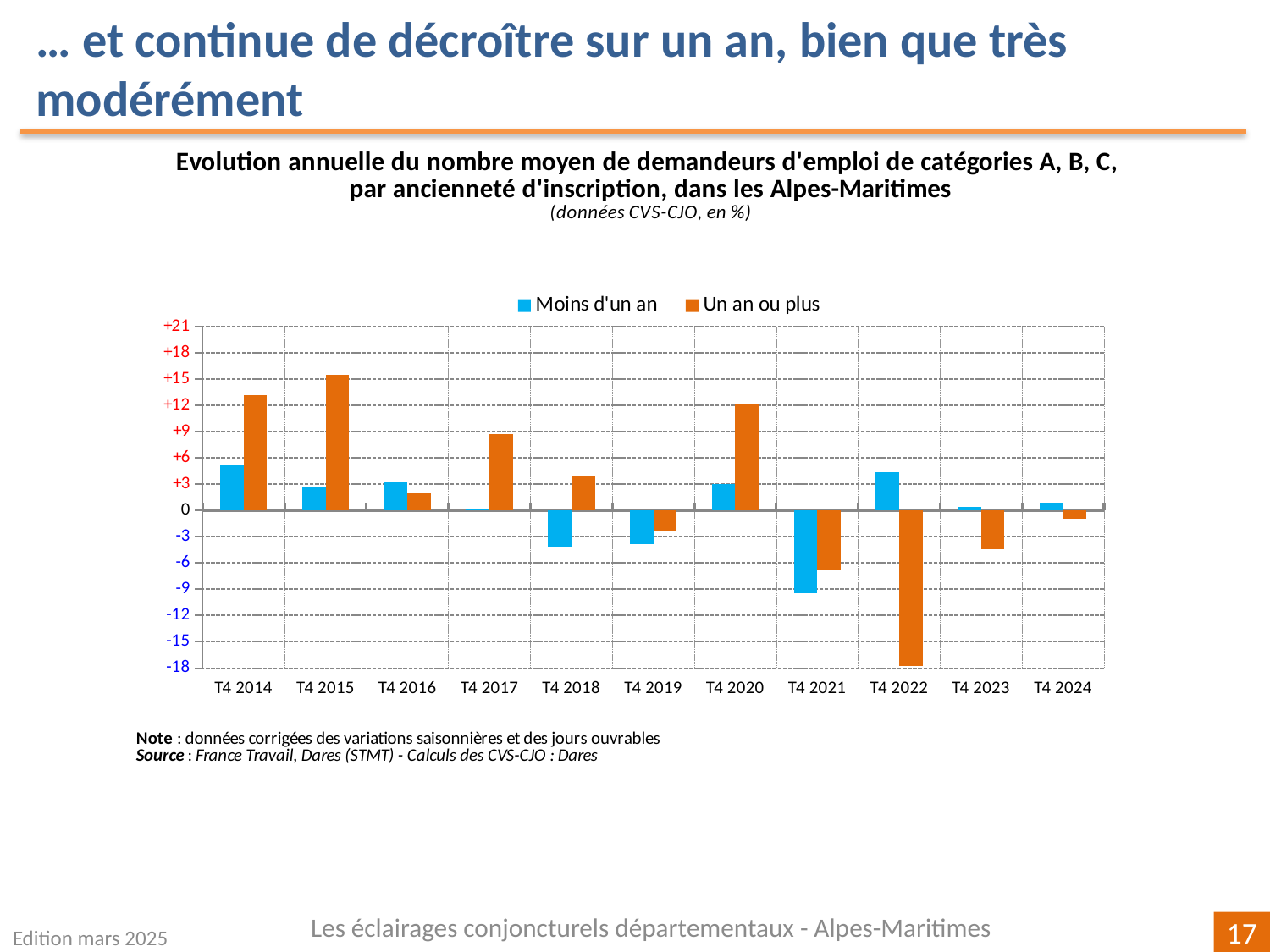
What are the two series named in the legend? Moins d'un an; Un an ou plus Which quarter has the lowest value for the 'Moins d'un an' series? T4 2021 What kind of chart is shown on the slide? bar chart How many quarters (categories) are shown on the x axis? 11 Which quarter has the lowest value for the 'Un an ou plus' series? T4 2022 Is the value for 'Un an ou plus' in T4 2014 greater or less than +12? greater Is the value for 'Un an ou plus' in T4 2022 greater or less than -15? less In T4 2022, which series has the larger value, 'Moins d'un an' or 'Un an ou plus'? Moins d'un an Is the value for 'Moins d'un an' in T4 2021 greater or less than -6? less How many series does the legend list? 2 In T4 2018, which series has the larger value, 'Moins d'un an' or 'Un an ou plus'? Un an ou plus Which quarter has the highest value for the 'Un an ou plus' series? T4 2015